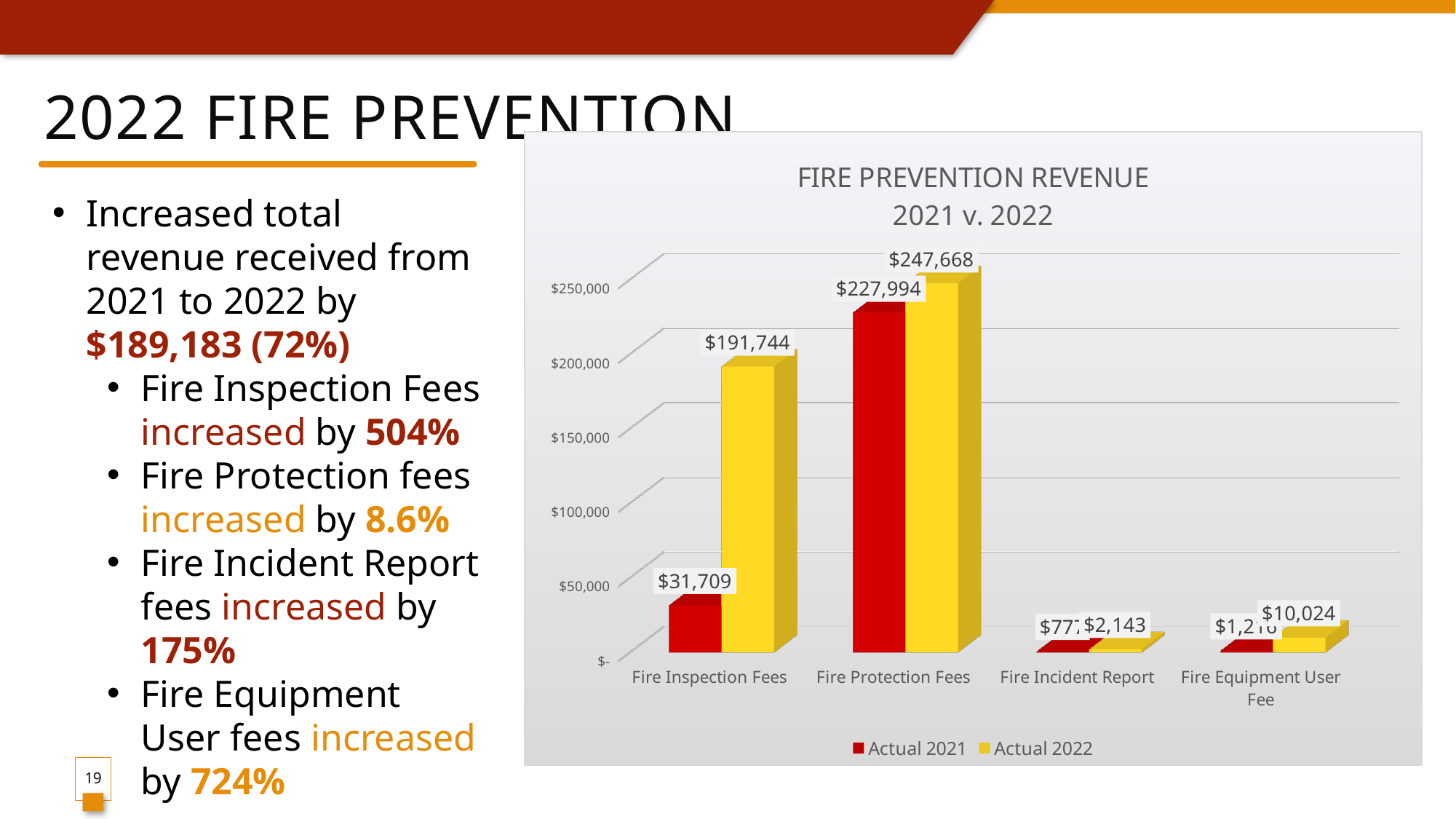
What is the title of the chart? FIRE PREVENTION REVENUE 2021 v. 2022 What is the Actual 2021 value for Fire Protection Fees? $227,994 What is the difference between the Actual 2022 and Actual 2021 values for Fire Inspection Fees? $160,035 What type of chart is shown on the slide? bar chart What is the Actual 2021 value for Fire Inspection Fees? $31,709 What is the Actual 2022 value for Fire Inspection Fees? $191,744 Which category has the highest Actual 2022 value? Fire Protection Fees Is the Actual 2022 value for Fire Protection Fees greater or less than $200,000? greater Which is larger for Fire Protection Fees, the Actual 2021 value or the Actual 2022 value? Actual 2022 How many series does the chart legend list? 2 How many categories are shown on the x axis of the chart? 4 What is the Actual 2022 value for Fire Equipment User Fee? $10,024